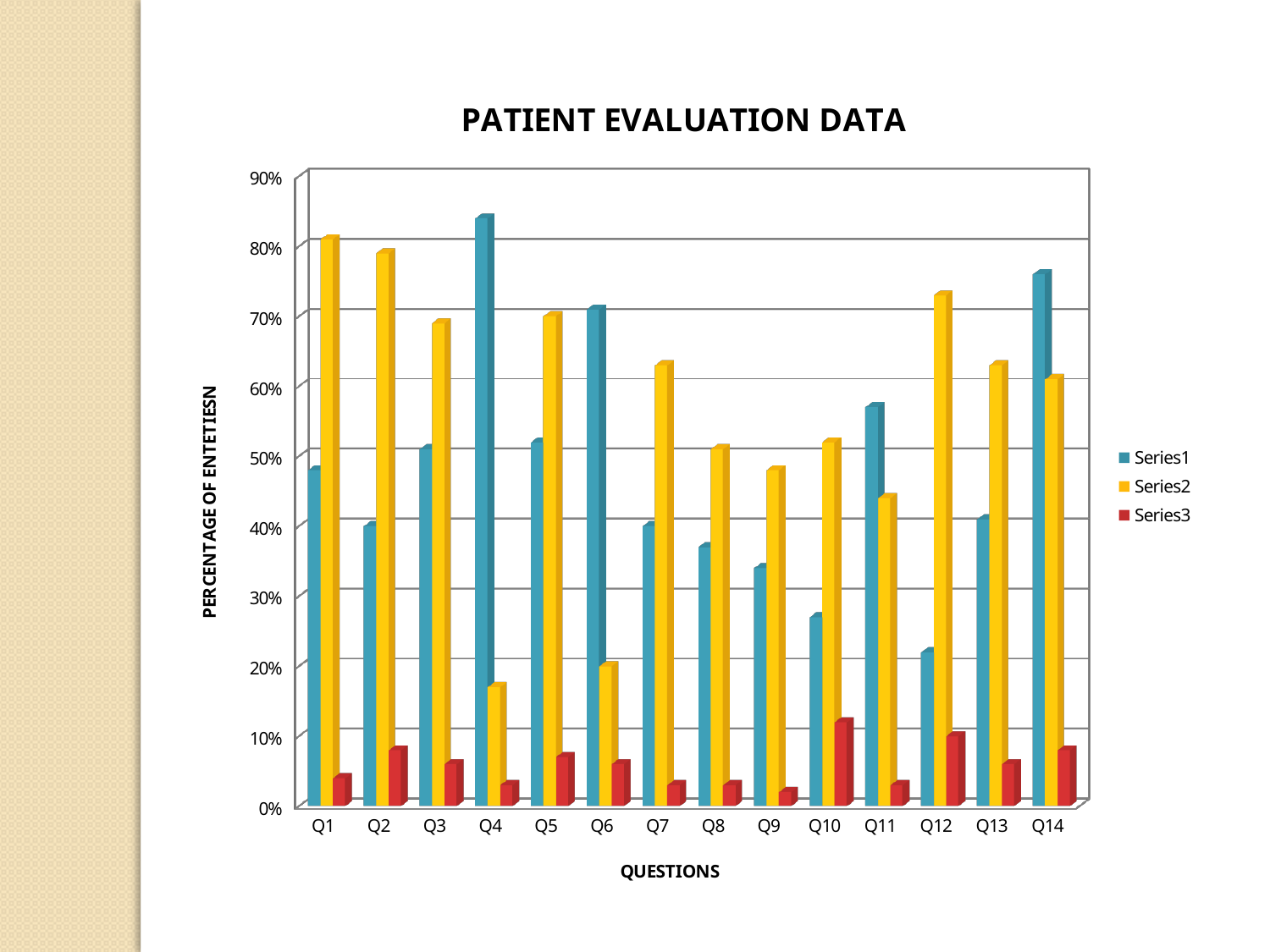
Is the Series2 value for Q4 greater or less than 20%? less Is the Series1 value for Q4 greater or less than 80%? greater Which question has the highest value for Series1? Q4 How many questions (categories) are shown on the x axis? 14 For Q1, which series has the larger value, Series1 or Series2? Series2 Which question has the lowest value for Series1? Q12 How many series does the legend list? 3 Is the Series2 value for Q12 greater or less than 70%? greater For Q6, which series has the larger value, Series1 or Series2? Series1 What is the label of the x axis? QUESTIONS What is the title of the chart? PATIENT EVALUATION DATA What type of chart is shown on the slide? Bar chart